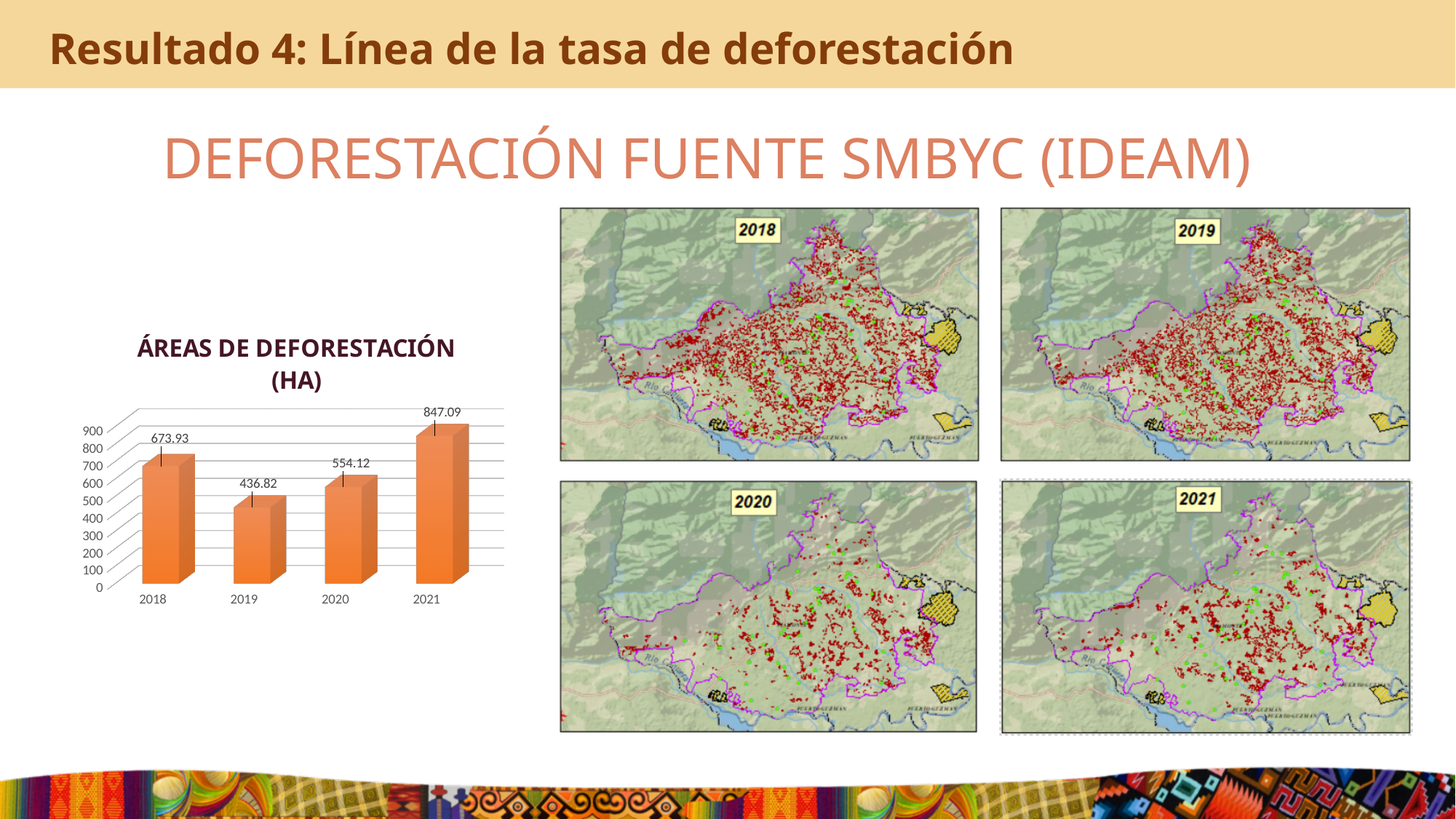
What is the value for 2019 in the ÁREAS DE DEFORESTACIÓN (HA) chart? 436.82 In the ÁREAS DE DEFORESTACIÓN (HA) chart, do the values rise or fall from 2019 to 2021? Rise What is the value for 2020 in the ÁREAS DE DEFORESTACIÓN (HA) chart? 554.12 What kind of chart is the ÁREAS DE DEFORESTACIÓN (HA) chart? Bar chart Which year has the lowest value in the ÁREAS DE DEFORESTACIÓN (HA) chart? 2019 Which year has the highest value in the ÁREAS DE DEFORESTACIÓN (HA) chart? 2021 What is the difference between the values for 2021 and 2019 in the ÁREAS DE DEFORESTACIÓN (HA) chart? 410.27 In the ÁREAS DE DEFORESTACIÓN (HA) chart, which is larger, the value for 2018 or the value for 2020? 2018 What is the value for 2018 in the ÁREAS DE DEFORESTACIÓN (HA) chart? 673.93 How many years are shown in the ÁREAS DE DEFORESTACIÓN (HA) chart? 4 What is the value for 2021 in the ÁREAS DE DEFORESTACIÓN (HA) chart? 847.09 What is the difference between the values for 2018 and 2020 in the ÁREAS DE DEFORESTACIÓN (HA) chart? 119.81